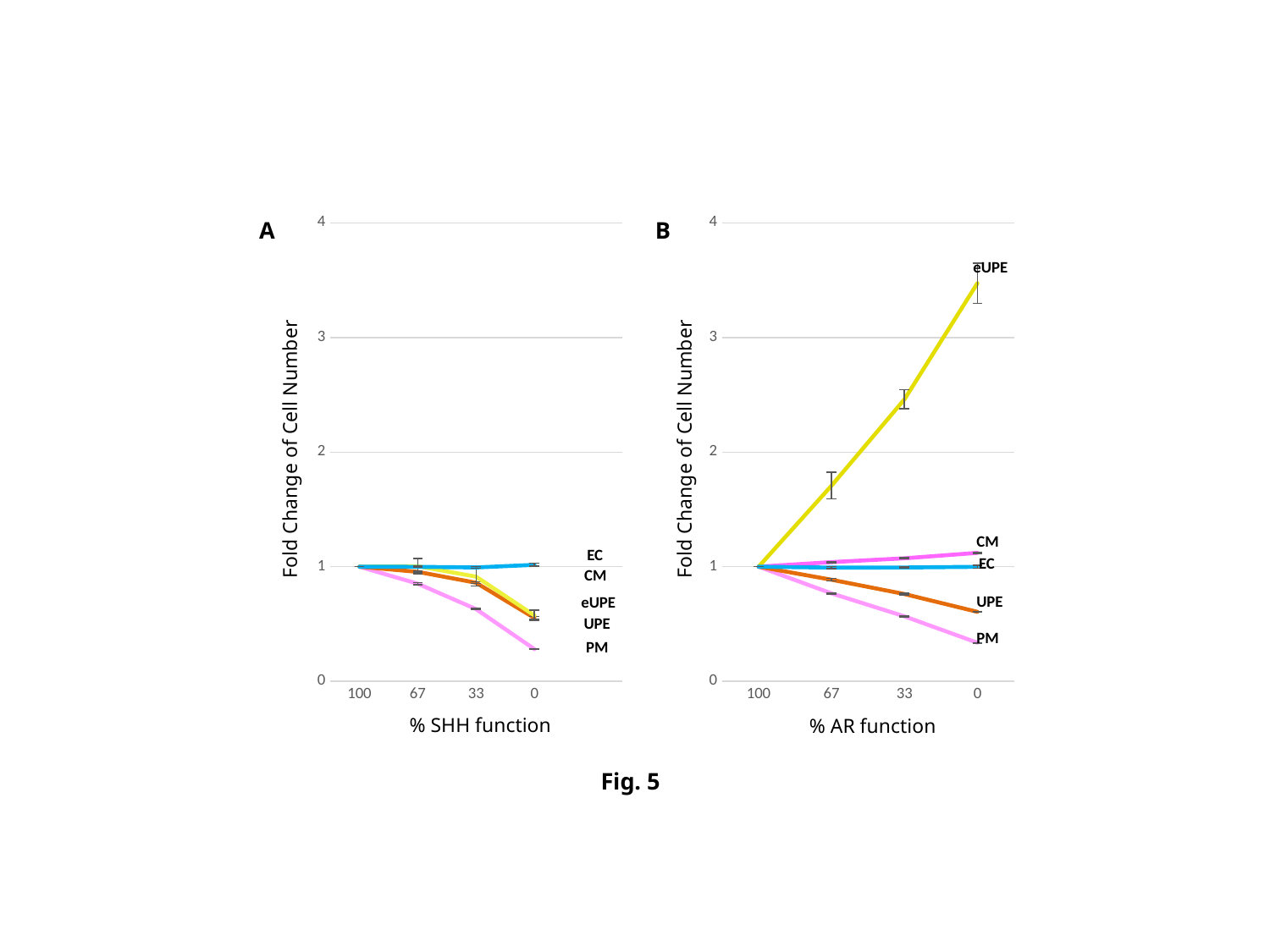
In chart B (% AR function), which series has the highest value at 0% AR function? eUPE In chart B (% AR function), does the eUPE line rise or fall from 100% to 0% AR function? rises In chart A (% SHH function), which series has the lowest value at 0% SHH function? PM In chart B (% AR function), is the value for eUPE at 67% AR function greater or less than 2? less What is the y-axis title of chart B? Fold Change of Cell Number In chart A (% SHH function), what is the fold change of cell number for PM at 100% SHH function? 1 How many points are on the x axis of chart B (% AR function)? 4 In chart A (% SHH function), is the value for PM at 0% SHH function greater or less than 1? less In chart B (% AR function), is the value for eUPE at 0% AR function greater or less than 3? greater How many series are labelled in chart A (% SHH function)? 5 In chart B (% AR function), which series has the lowest value at 0% AR function? PM What kind of chart is chart A (% SHH function)? line chart